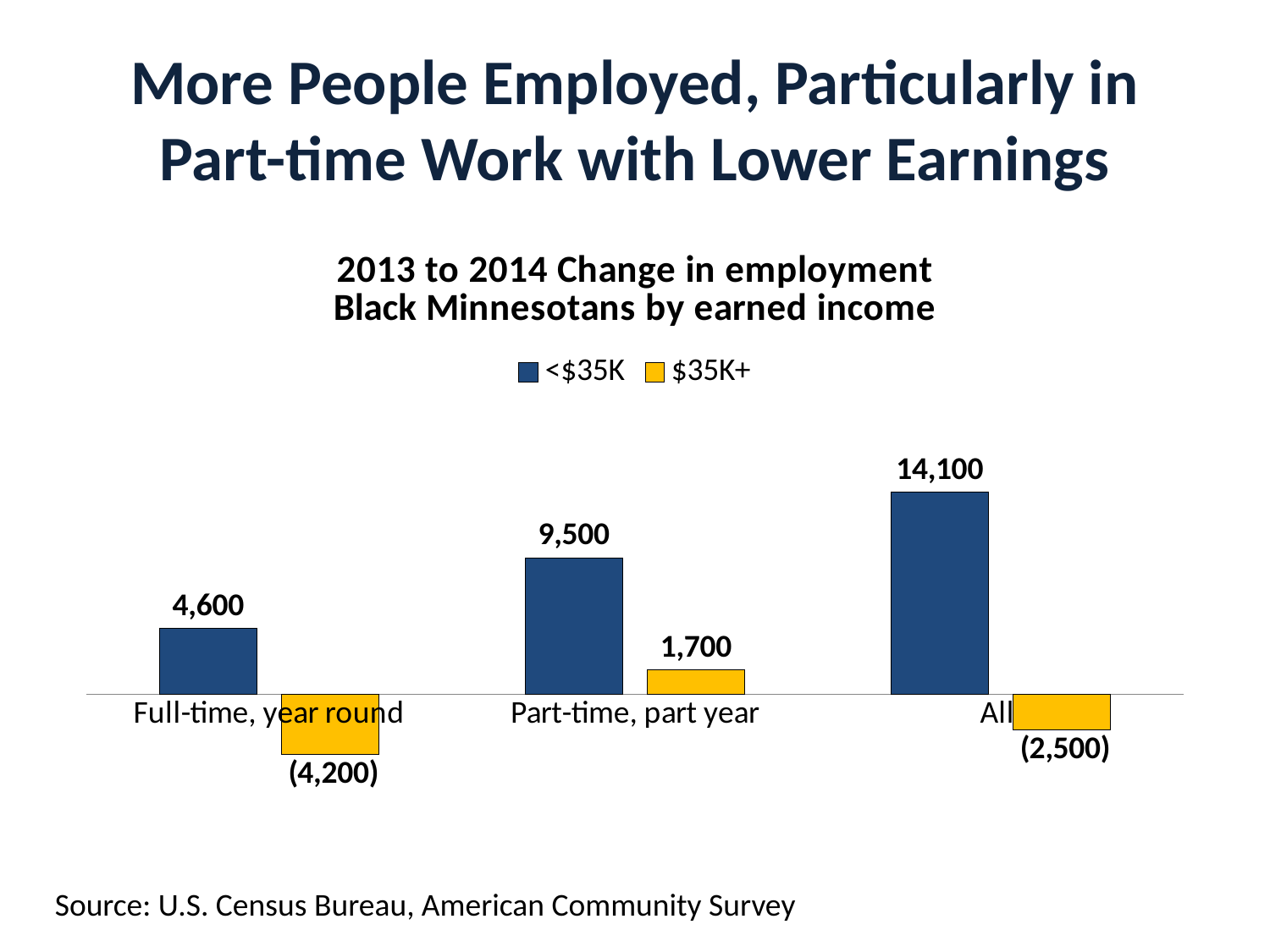
Which category has the lowest value for the $35K+ series? Full-time, year round What is the value for $35K+ in the Part-time, part year category? 1,700 What is the value for $35K+ in the Full-time, year round category? (4,200) What kind of chart is shown on the slide? Bar chart What is the value for $35K+ in the All category? (2,500) What is the difference between the <$35K and $35K+ values in the Part-time, part year category? 7,800 What is the value for <$35K in the Part-time, part year category? 9,500 How many series does the legend list? 2 What is the value for <$35K in the Full-time, year round category? 4,600 Which is larger in the Full-time, year round category: the <$35K value or the $35K+ value? <$35K Which category has the highest value for the <$35K series? All What is the value for <$35K in the All category? 14,100